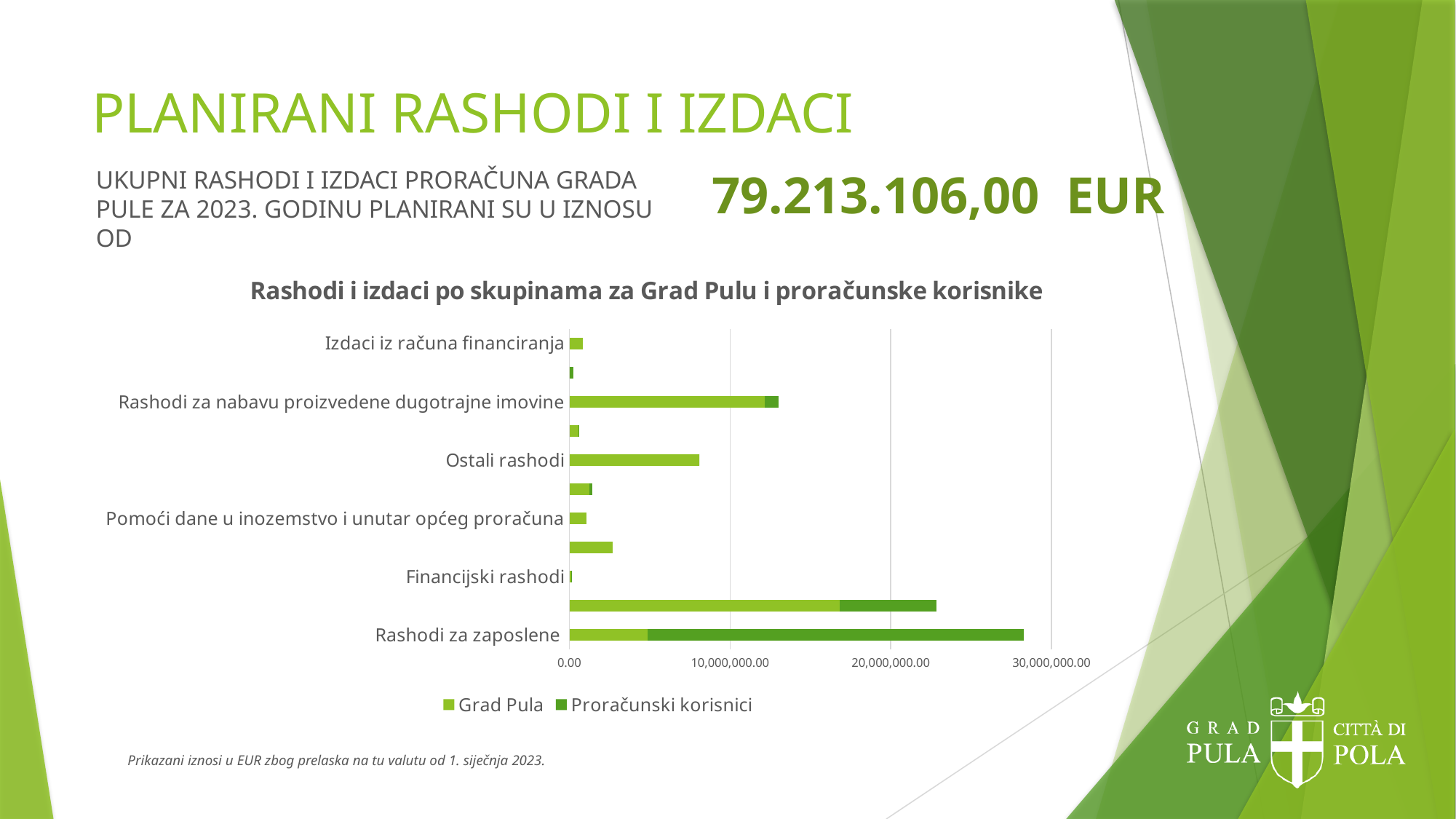
How many series does the chart legend list? 2 For Rashodi za zaposlene, which series has the larger segment, Grad Pula or Proračunski korisnici? Proračunski korisnici Is the value for Ostali rashodi greater or less than 10,000,000.00? less What is the title of the chart? Rashodi i izdaci po skupinama za Grad Pulu i proračunske korisnike How many bars are plotted in the chart? 11 What are the two series named in the chart legend? Grad Pula and Proračunski korisnici What kind of chart is shown on the slide? Bar chart Is the total value for Rashodi za zaposlene greater or less than 20,000,000.00? greater Is the total value for Rashodi za zaposlene greater or less than 30,000,000.00? less Which is larger, the bar for Rashodi za zaposlene or the bar for Ostali rashodi? Rashodi za zaposlene Which category has the longest bar in the chart? Rashodi za zaposlene